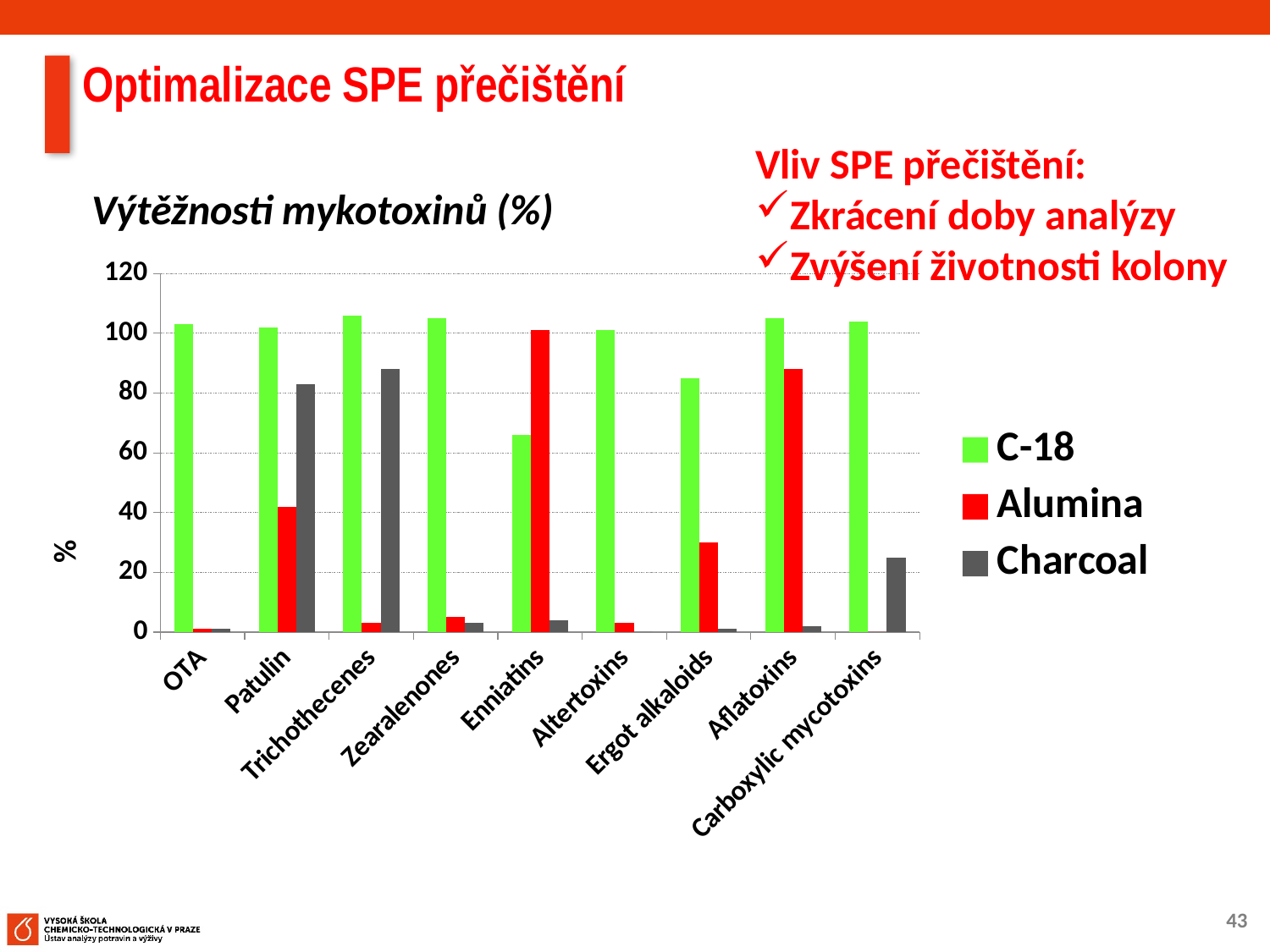
What kind of chart is shown on the slide? bar chart How many mycotoxin categories are shown on the x axis? 9 What is the label on the y axis of the chart? % How many series does the legend list? 3 For Patulin, which is larger: the Alumina value or the Charcoal value? Charcoal Is the C-18 value for Enniatins greater or less than 80? less Which category has the highest Alumina recovery? Enniatins Which category has the lowest C-18 recovery? Enniatins Is the Charcoal value for Carboxylic mycotoxins greater or less than 20? greater Is the Alumina value for Ergot alkaloids greater or less than 40? less For Enniatins, which is larger: the C-18 value or the Alumina value? Alumina